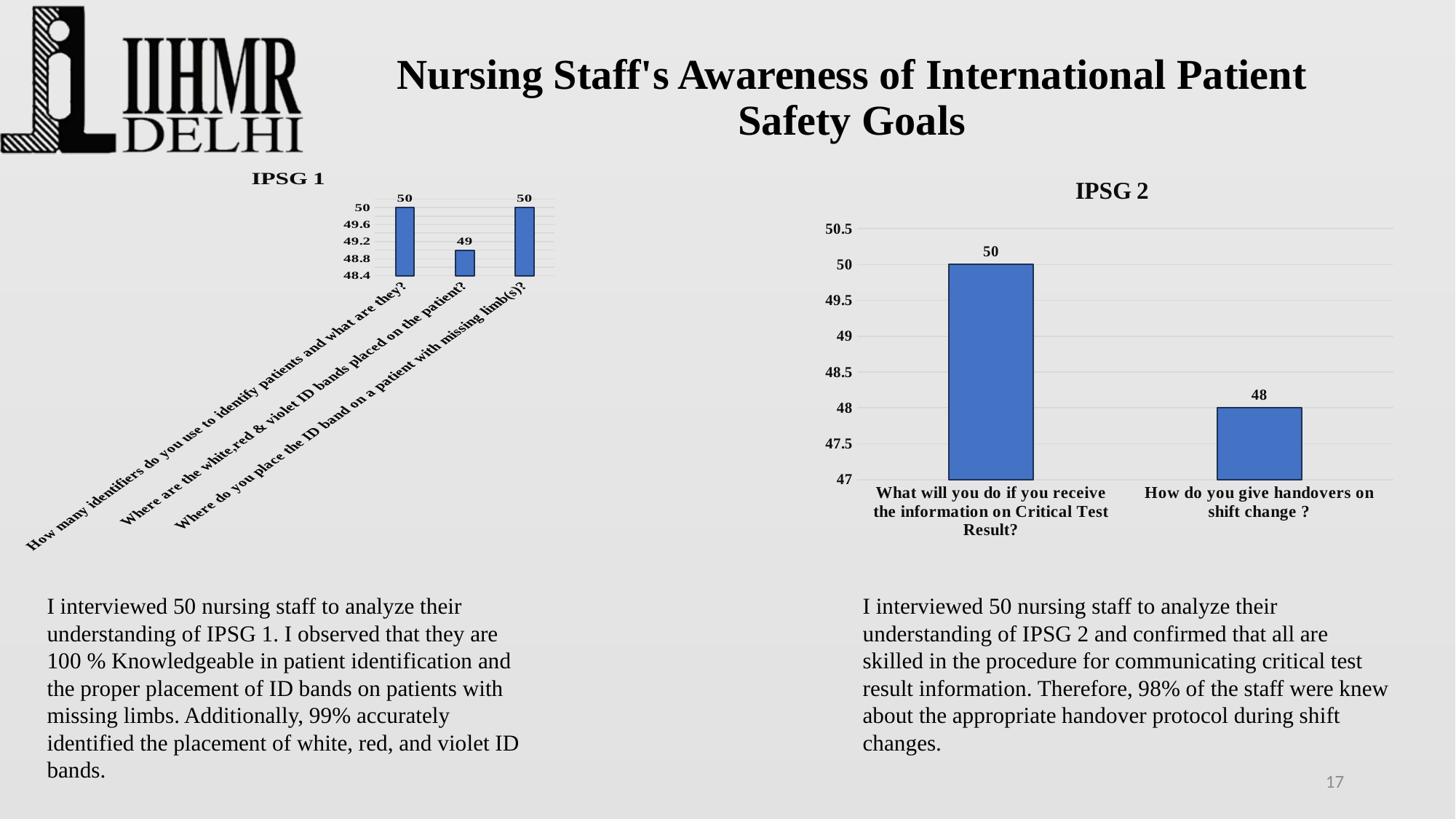
In the IPSG 1 chart, which category has the lowest value? Where are the white,red & violet ID bands placed on the patient? In the IPSG 1 chart, what is the value for "How many identifiers do you use to identify patients and what are they?"? 50 In the IPSG 2 chart, which category has the highest value? What will you do if you receive the information on Critical Test Result? In the IPSG 2 chart, what is the difference between the two bars? 2 How many bars are plotted in the IPSG 1 chart? 3 In the IPSG 2 chart, what is the value for "What will you do if you receive the information on Critical Test Result?"? 50 What type of chart is the IPSG 2 chart? Bar chart In the IPSG 1 chart, what is the value for "Where are the white,red & violet ID bands placed on the patient?"? 49 In the IPSG 2 chart, is the value for "How do you give handovers on shift change ?" greater or less than 49? less How many bars are plotted in the IPSG 2 chart? 2 What is the title of the chart on the right side of the slide? IPSG 2 In the IPSG 2 chart, what is the value for "How do you give handovers on shift change ?"? 48